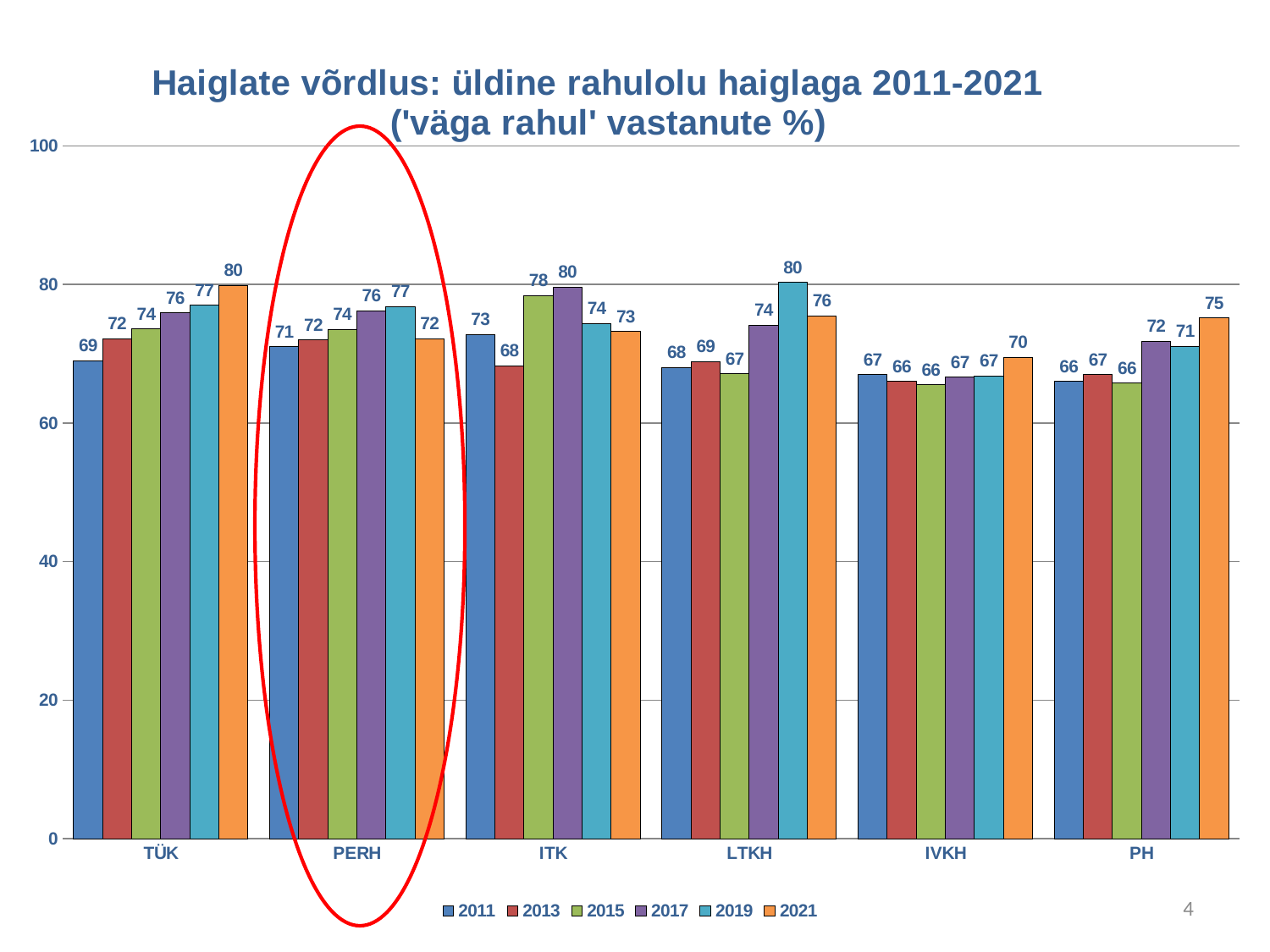
What is the difference between the 2021 and 2011 values for TÜK? 11 Which is larger, the 2021 value for PERH or the 2021 value for LTKH? LTKH What is the value for LTKH in 2019? 80 What is the value for PH in 2021? 75 What kind of chart is shown on the slide? Bar chart How many hospitals are shown on the x axis? 6 Which hospital has the highest value in 2015? ITK What is the value for PERH in 2011? 71 How many series does the legend list? 6 What is the value for ITK in 2017? 80 What is the value for TÜK in 2021? 80 Which hospital has the lowest value in 2021? IVKH